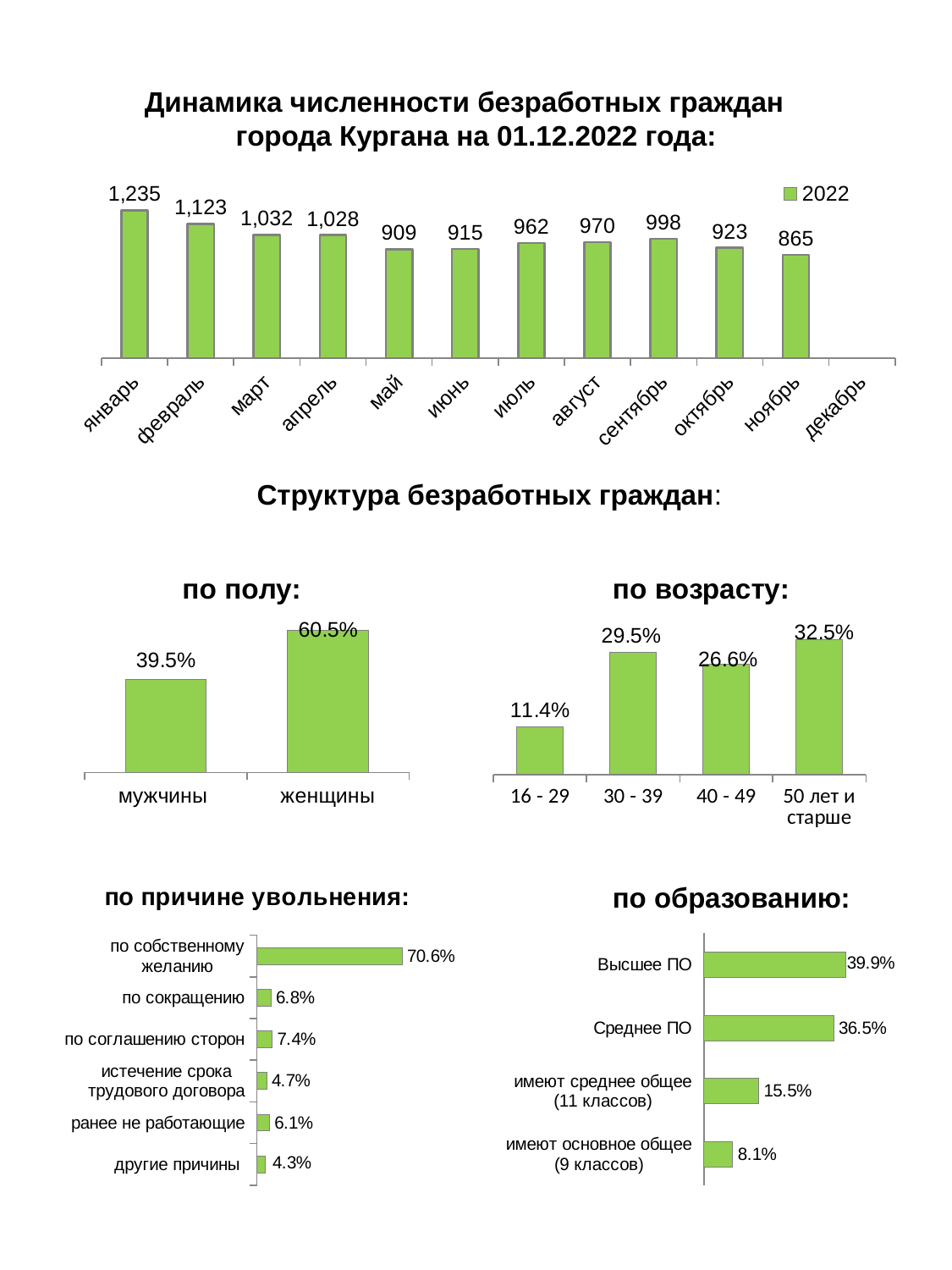
In the chart 'Динамика численности безработных граждан города Кургана на 01.12.2022 года', what is the value for январь? 1,235 In the chart 'по полу', what is the value for женщины? 60.5% In the chart 'по возрасту', which age group has the highest value? 50 лет и старше What kind of chart is 'по образованию'? bar chart In the chart 'Динамика численности безработных граждан города Кургана на 01.12.2022 года', what is the difference between the values for январь and ноябрь? 370 In the chart 'по причине увольнения', which category has the lowest value? другие причины In the chart 'Динамика численности безработных граждан города Кургана на 01.12.2022 года', which series does the legend list? 2022 In the chart 'Динамика численности безработных граждан города Кургана на 01.12.2022 года', which month has the lowest value among the plotted bars? ноябрь In the chart 'Динамика численности безработных граждан города Кургана на 01.12.2022 года', how many months have a plotted bar? 11 In the chart 'по возрасту', what is the value for 16 - 29? 11.4% In the chart 'по причине увольнения', what is the value for 'по соглашению сторон'? 7.4% In the chart 'по образованию', which is larger: Высшее ПО or Среднее ПО? Высшее ПО